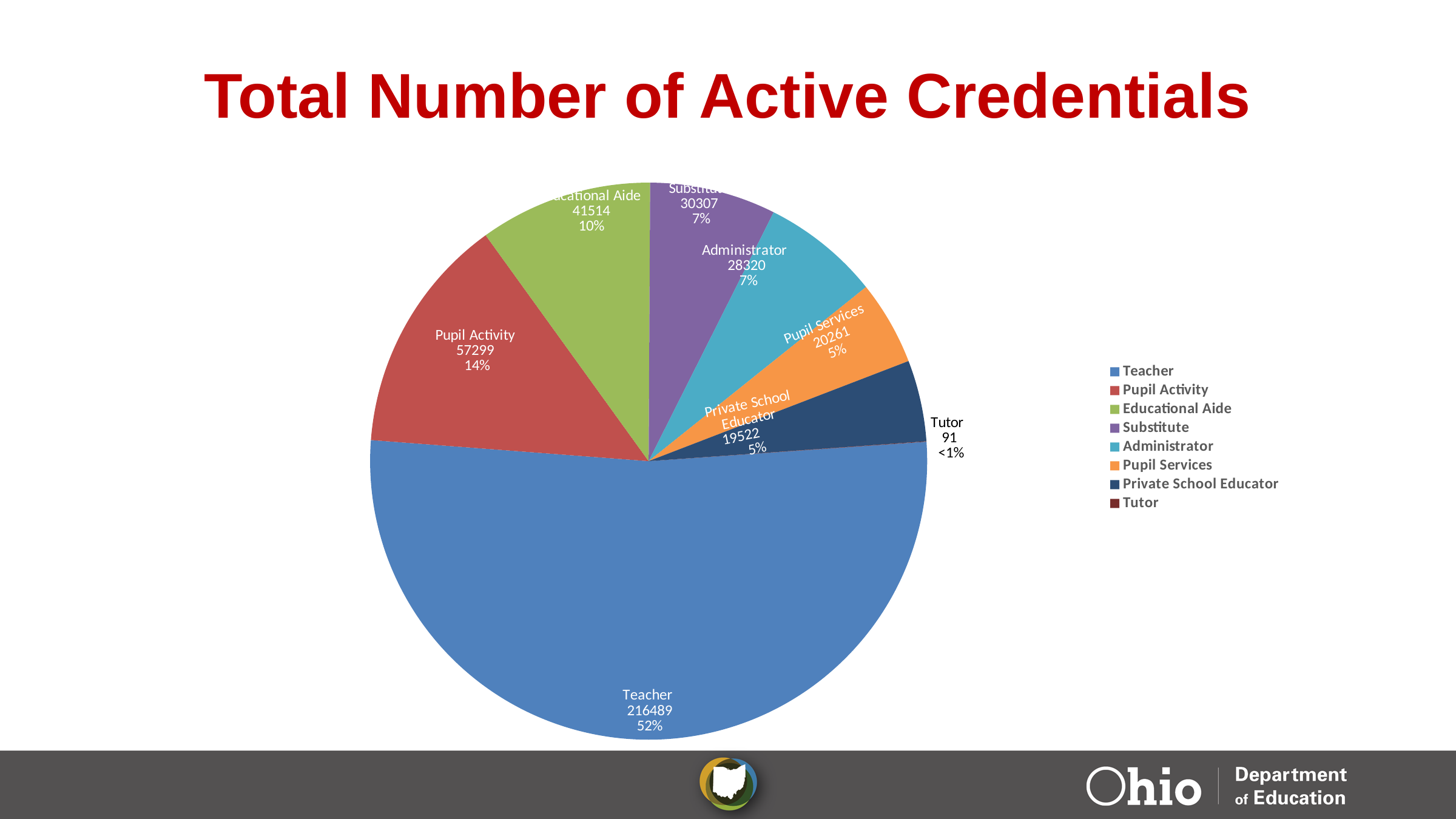
What is the number of active credentials for Pupil Activity? 57299 What type of chart is shown on the slide? Pie chart What percentage share of active credentials does Pupil Activity hold? 14% How many categories does the legend list? 8 What percentage share of active credentials does Educational Aide hold? 10% Which category has the smallest share of active credentials? Tutor Which category has the largest share of active credentials? Teacher Which has more active credentials, Substitute or Administrator? Substitute What is the number of active credentials for Teacher? 216489 What is the number of active credentials for Tutor? 91 What is the number of active credentials for Administrator? 28320 What is the difference between the Pupil Activity and Educational Aide credential counts? 15785